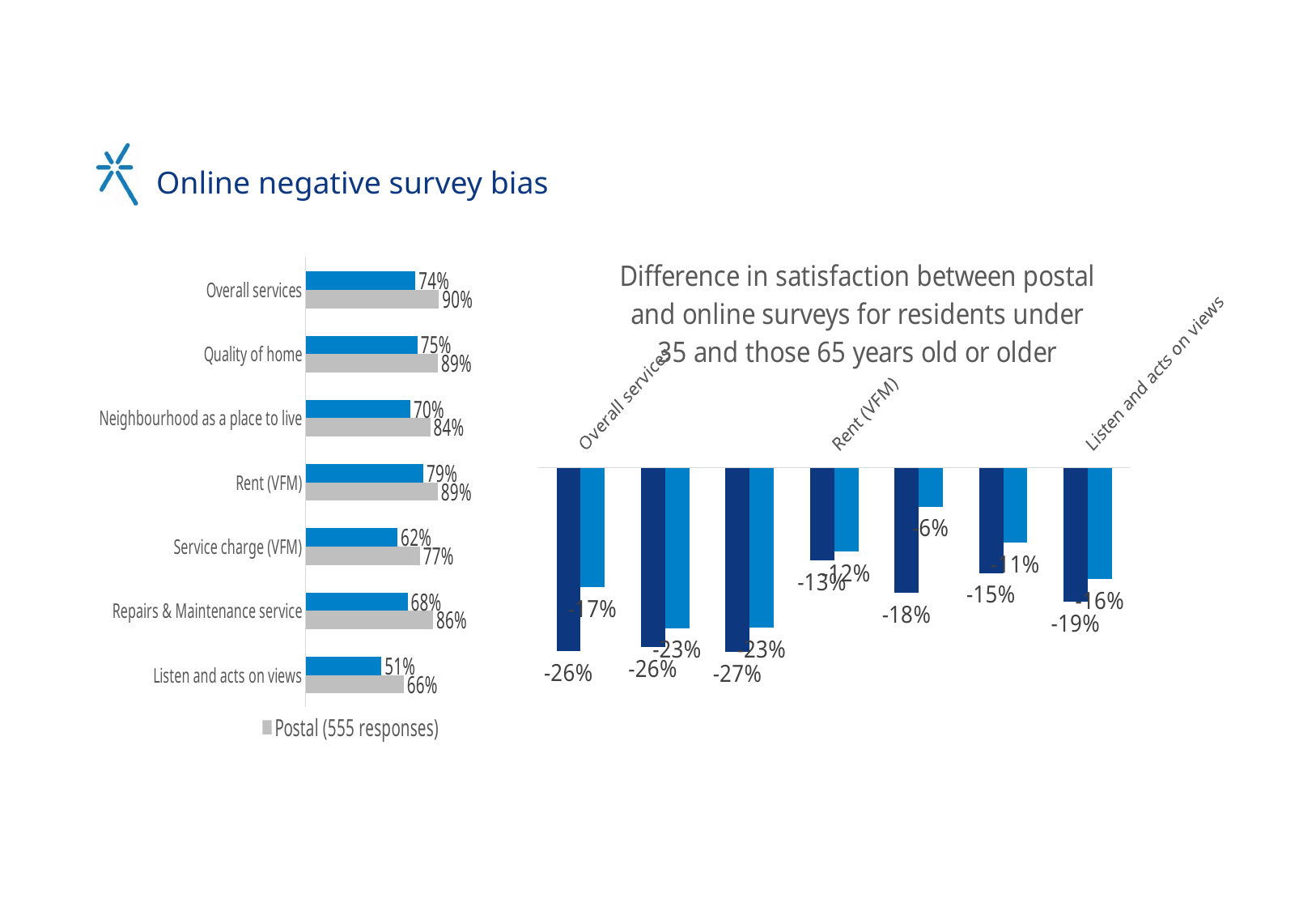
In the left chart, what is the difference between the Postal (555 responses) value and the blue bar value for Repairs & Maintenance service? 18% In the chart titled 'Difference in satisfaction between postal and online surveys for residents under 35 and those 65 years old or older', what is the value of the dark blue bar for Overall services? -26% What type of chart is the left chart? bar chart In the left chart, what is the value of the blue bar for Listen and acts on views? 51% How many categories are shown in the left chart? 7 In the left chart, which category has the lowest Postal (555 responses) value? Listen and acts on views In the left chart, is the blue bar value for Quality of home larger or smaller than the blue bar value for Neighbourhood as a place to live? larger In the left chart, what is the Postal (555 responses) value for Overall services? 90% In the left chart, which category has the highest value for the blue bars? Rent (VFM) In the left chart, what is the Postal (555 responses) value for Service charge (VFM)? 77% In the chart titled 'Difference in satisfaction between postal and online surveys for residents under 35 and those 65 years old or older', what is the value of the light blue bar for Listen and acts on views? -16% In the chart titled 'Difference in satisfaction between postal and online surveys for residents under 35 and those 65 years old or older', what is the value of the light blue bar for Rent (VFM)? -12%